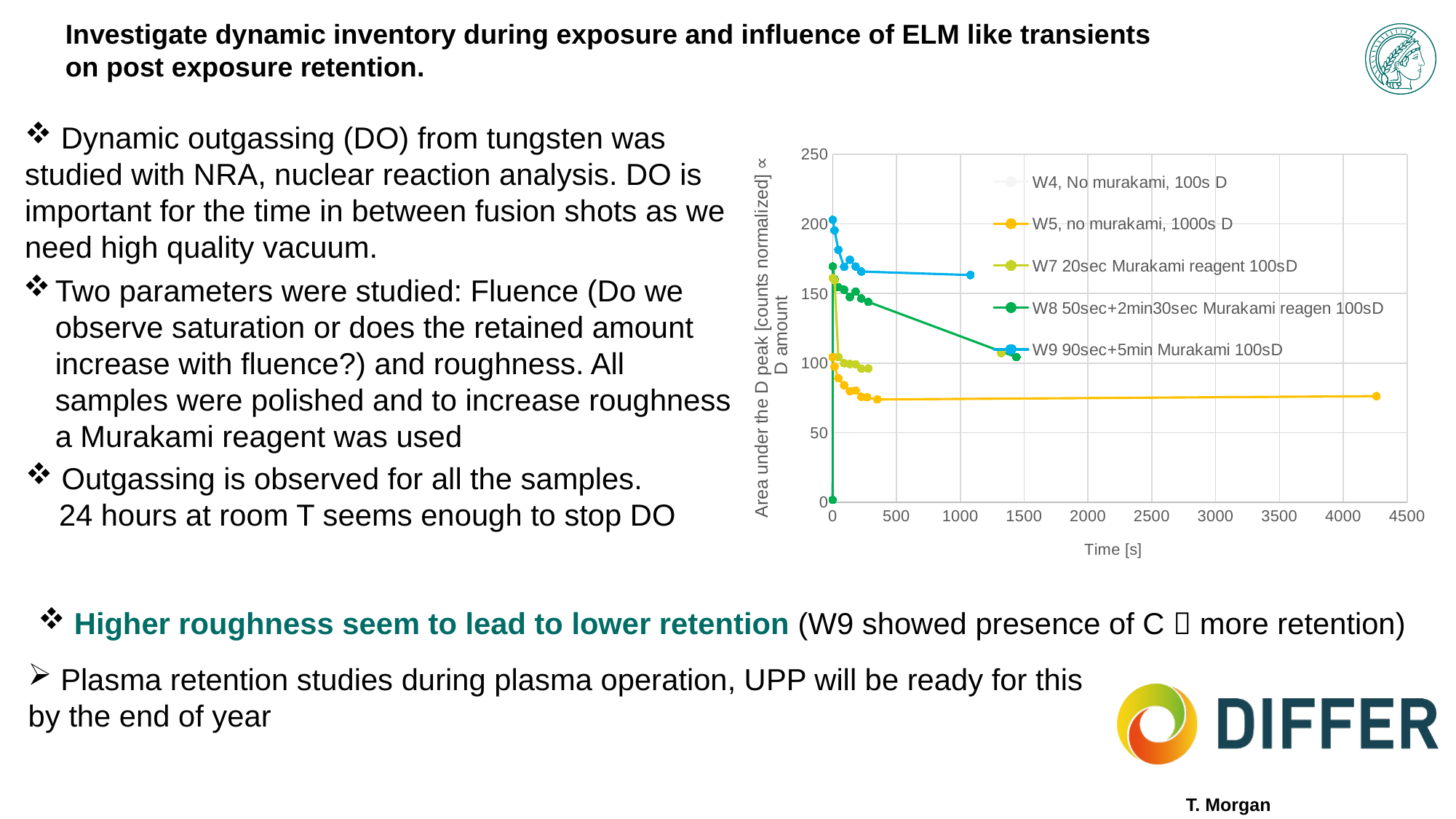
Is the value of the W9 series at around 1100 s greater or less than 150? greater At around 1100 s, which series has the larger value, W9 or W5? W9 How many series does the chart legend list? 5 What is the highest tick value shown on the y axis of the chart? 250 What is the label of the x axis of the chart? Time [s] What kind of chart is shown on the slide? line chart Is the value of the W8 series at around 1400 s greater or less than 150? less Do the values of the W9 series rise or fall as time increases? fall Which series in the legend is described as 'no murakami, 1000s D'? W5 Which series extends to the largest time value on the x axis? W5 Is the value of the W5 series at its last point (around 4250 s) greater or less than 100? less